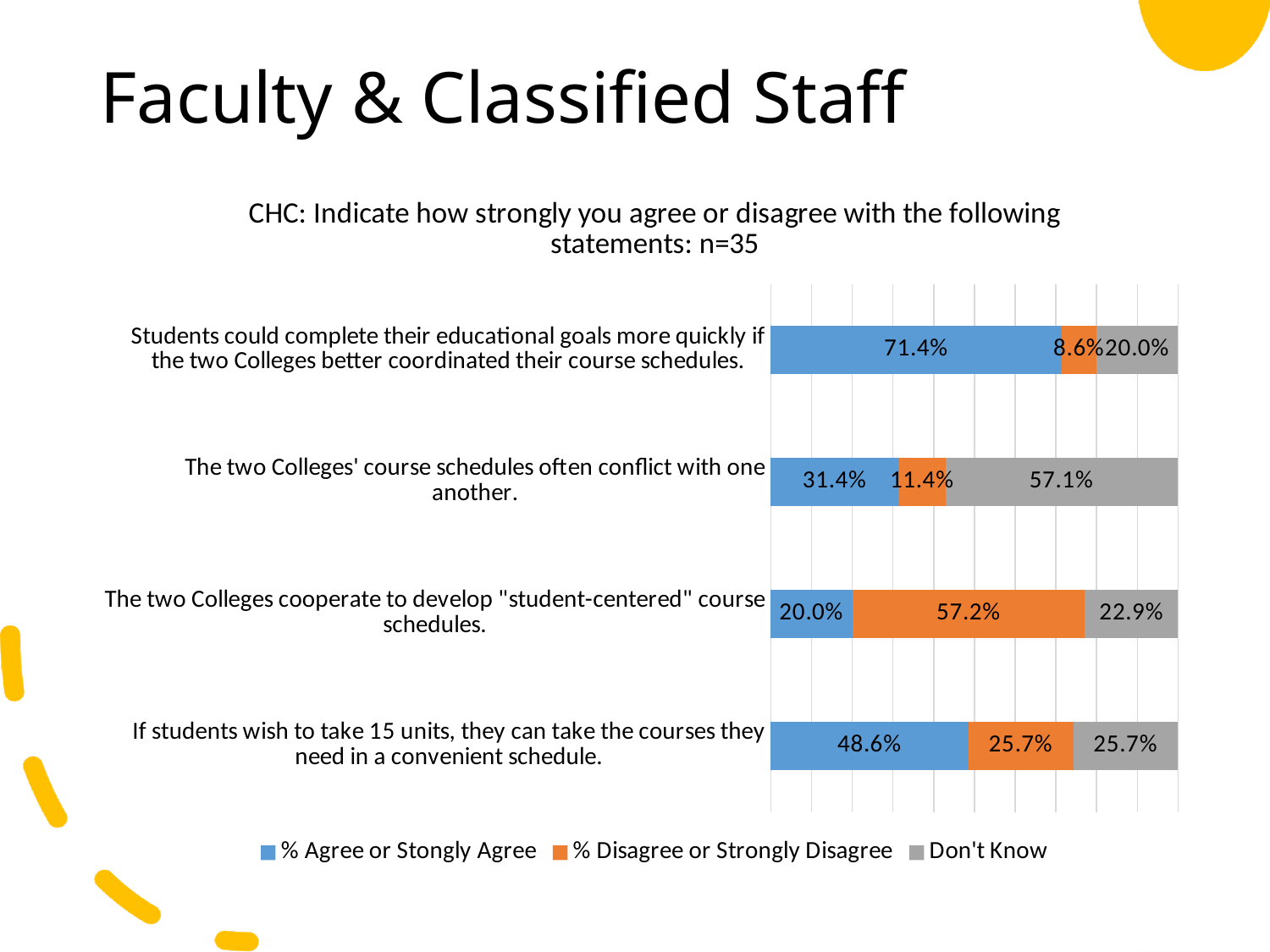
Which statement has the highest % Agree or Strongly Agree value? Students could complete their educational goals more quickly if the two Colleges better coordinated their course schedules. What kind of chart is shown on the slide? Stacked bar chart How many series does the legend list? 3 What is the Don't Know percentage for the statement "The two Colleges' course schedules often conflict with one another"? 57.1% What is the sample size (n) given in the chart title? 35 What percentage agree or strongly agree that if students wish to take 15 units, they can take the courses they need in a convenient schedule? 48.6% How many statements are shown in the chart? 4 What is the difference between the % Agree or Strongly Agree values for the statement about completing educational goals more quickly (71.4%) and the statement about the two Colleges cooperating on "student-centered" schedules (20.0%)? 51.4% What percentage disagree or strongly disagree that the two Colleges cooperate to develop "student-centered" course schedules? 57.2% What percentage of respondents agree or strongly agree that students could complete their educational goals more quickly if the two Colleges better coordinated their course schedules? 71.4% Which statement has the lowest % Disagree or Strongly Disagree value? Students could complete their educational goals more quickly if the two Colleges better coordinated their course schedules. For the statement about taking 15 units, which is larger: the % Agree or Strongly Agree value or the % Disagree or Strongly Disagree value? % Agree or Strongly Agree